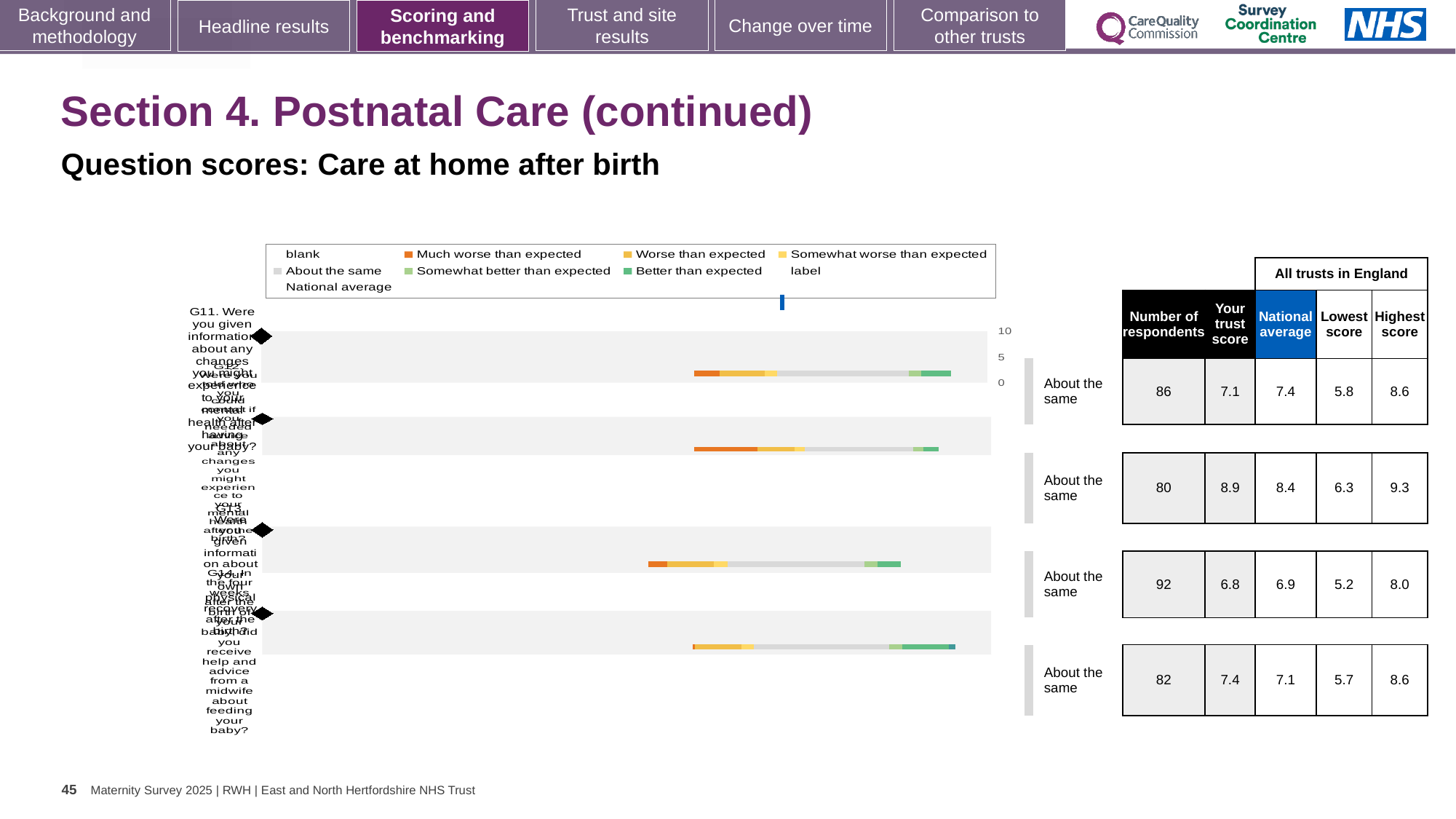
How many entries does the chart legend list? 9 How many question rows (bars) are plotted in the chart? 4 For the second row of the table, what is the difference between 'Your trust score' and the national average? 0.5 Which row in the table has the highest 'Your trust score'? the second row (8.9) In the table beside the chart, what is 'Your trust score' for the second row? 8.9 What colour represents 'Much worse than expected' in the chart legend? orange In the table beside the chart, what is the national average for the third row? 6.9 In the table beside the chart, what is the number of respondents for the first row? 86 What is the subtitle above the chart describing the question scores? Question scores: Care at home after birth For the first row of the table, which is larger: 'Your trust score' or the national average? national average What kind of chart is shown on the slide? bar chart In the table beside the chart, what is the highest score for the fourth row? 8.6